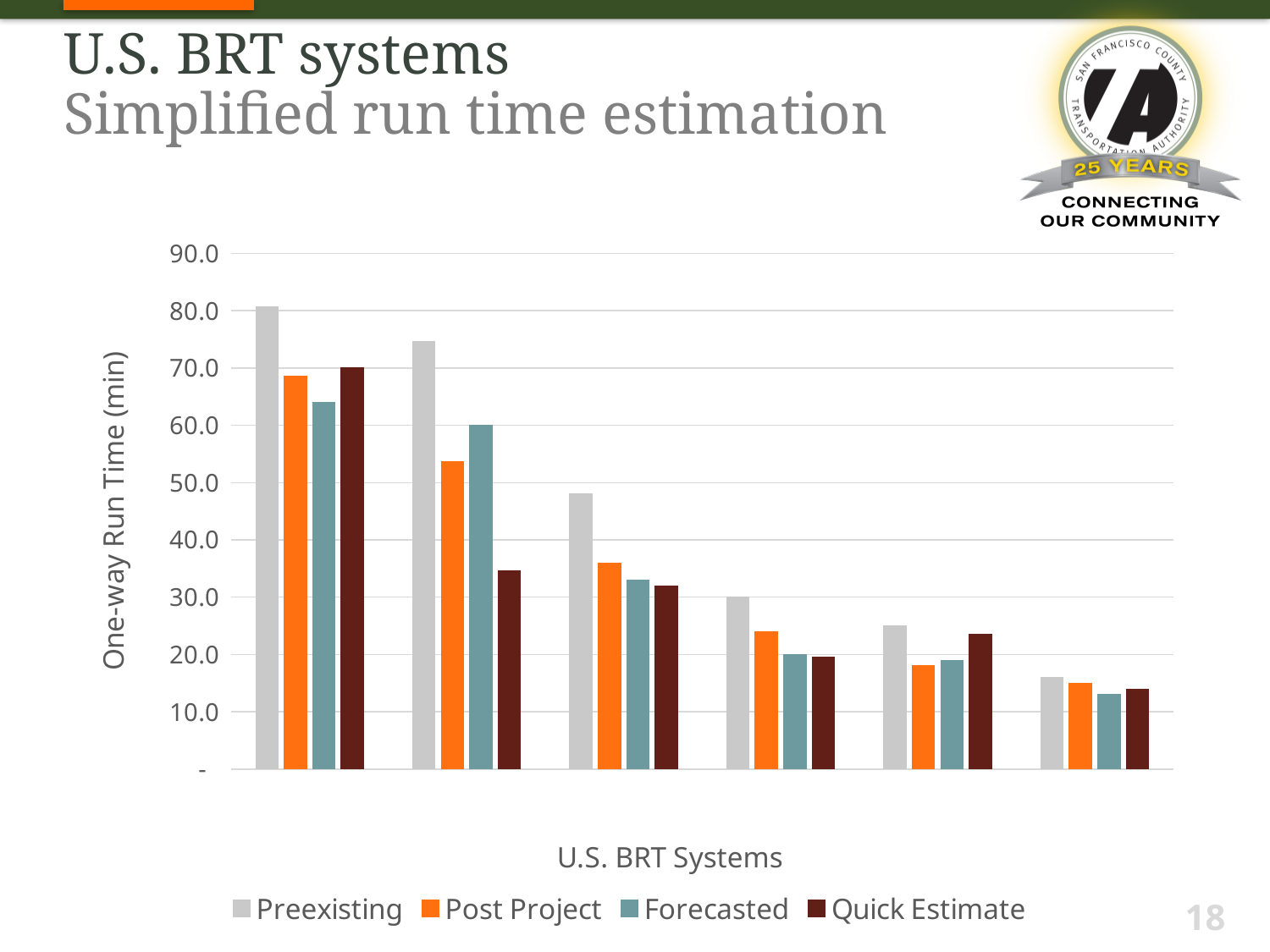
Do the Preexisting values rise or fall from left to right across the groups? fall Is the Preexisting value for the leftmost group of bars greater or less than 70? greater In the second group of bars from the left, which is larger: Post Project or Forecasted? Forecasted In the leftmost group of bars, which series has the highest value? Preexisting What is the title of the horizontal axis? U.S. BRT Systems Is the Quick Estimate value for the second group of bars from the left greater or less than 40? less What is the title of the vertical axis? One-way Run Time (min) How many series does the legend list? 4 What kind of chart is shown on the slide? bar chart How many groups of bars are plotted along the x axis? 6 Is the Preexisting value for the third group of bars from the left greater or less than 40? greater